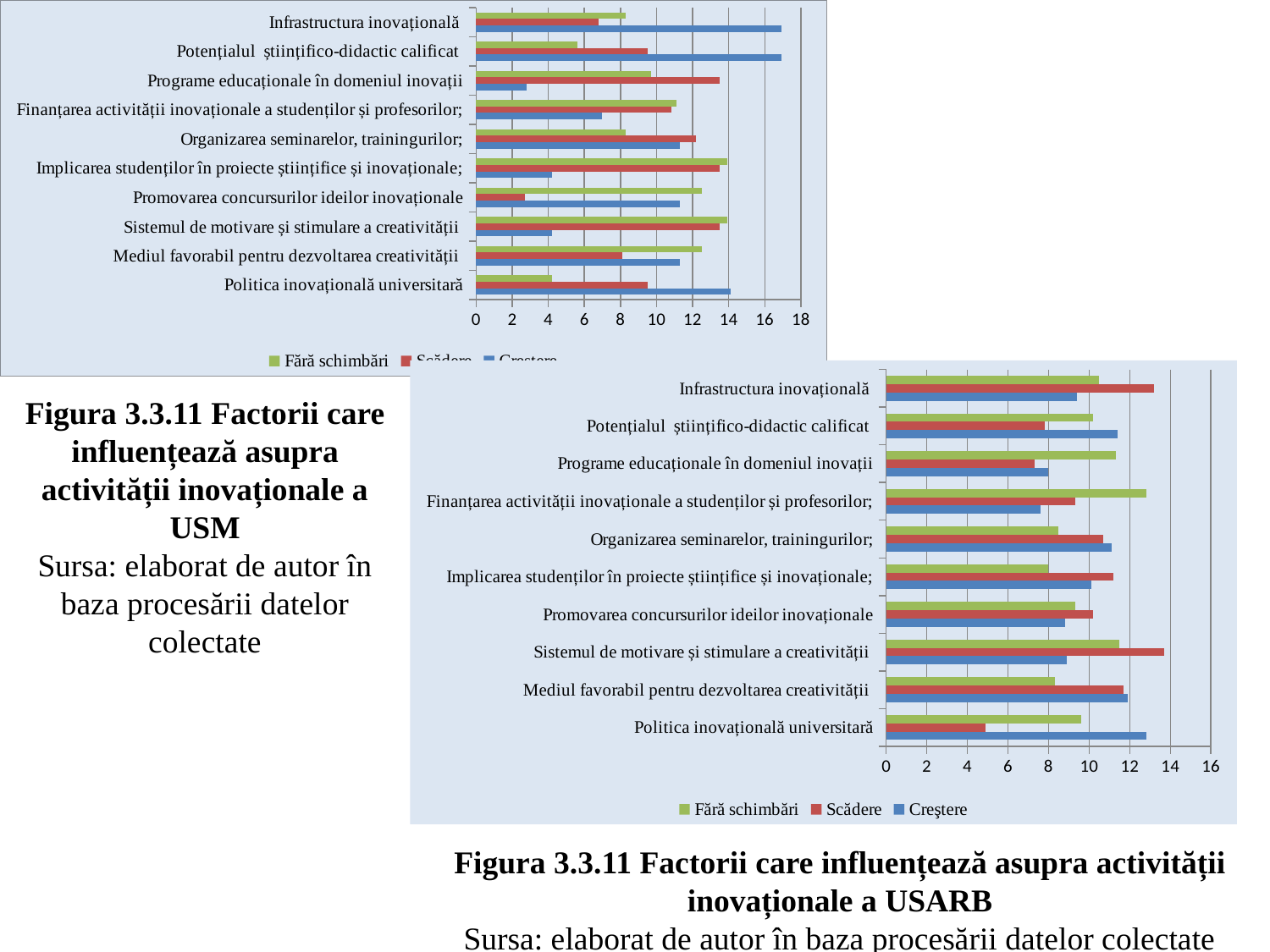
In the top-left chart (USM), which category has the lowest Scădere value? Promovarea concursurilor ideilor inovaționale In the bottom-right chart (USARB), which category has the highest Fără schimbări value? Finanțarea activității inovaționale a studenților și profesorilor; How many series does the legend of the bottom-right chart (USARB) list? 3 In the top-left chart (USM), for 'Politica inovațională universitară', which is larger: Creștere or Scădere? Creștere In the bottom-right chart (USARB), which category has the lowest Scădere value? Politica inovațională universitară In the bottom-right chart (USARB), is the Scădere value for 'Politica inovațională universitară' greater or less than 6? less What kind of chart is the top-left chart (USM)? bar chart In the top-left chart (USM), which category has the lowest Fără schimbări value? Politica inovațională universitară In the top-left chart (USM), is the Creștere value for 'Infrastructura inovațională' greater or less than 16? greater In the top-left chart (USM), is the Creștere value for 'Programe educaționale în domeniul inovații' greater or less than 4? less What are the three legend entries of the bottom-right chart (USARB)? Fără schimbări, Scădere, Creștere How many categories are shown on the top-left chart (USM)? 10